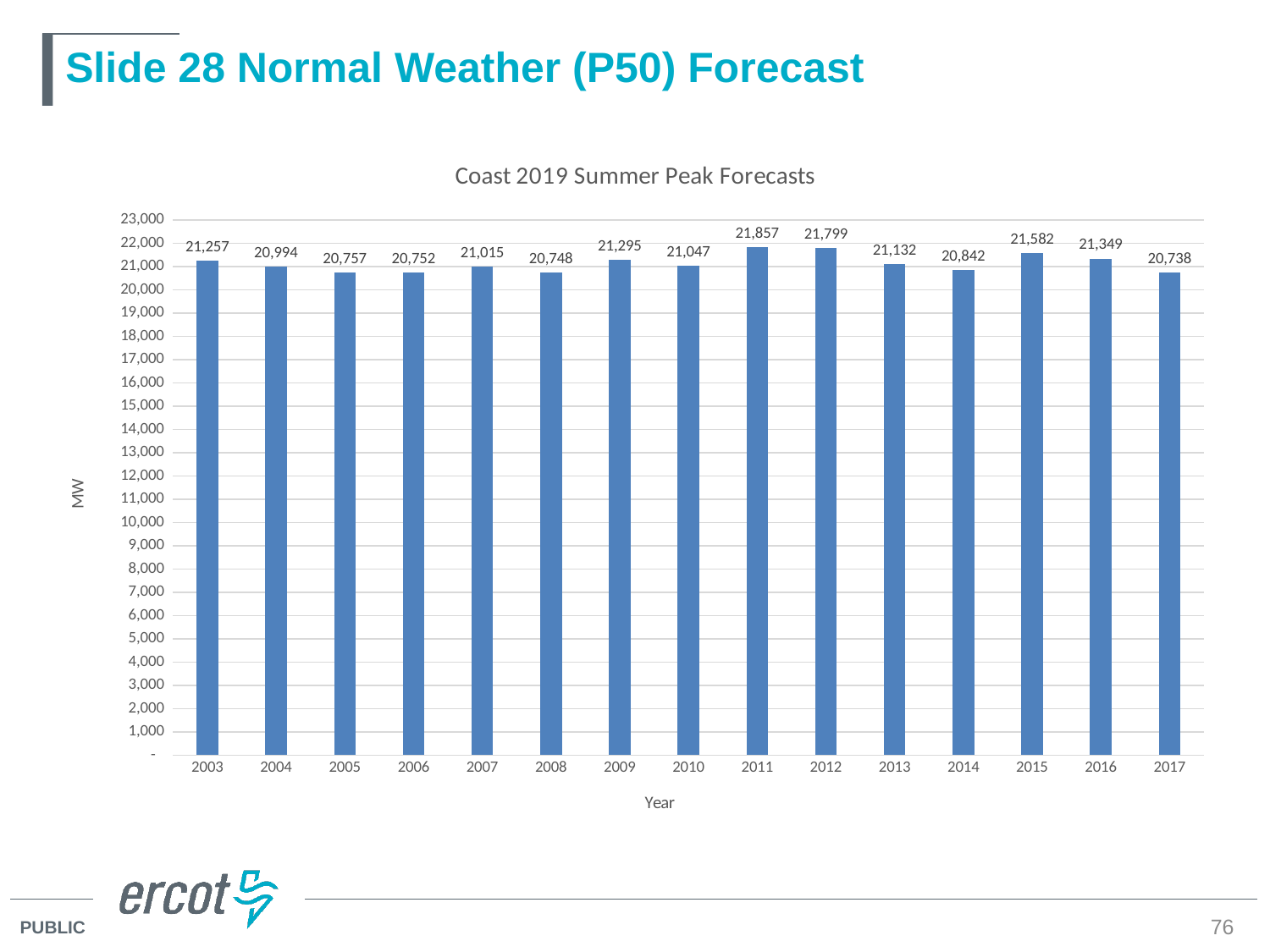
Which is larger, the value for 2015 or the value for 2016? 2015 What is the difference between the 2011 and 2012 forecast values? 58 What is the title of the chart? Coast 2019 Summer Peak Forecasts What is the forecast value for 2017? 20,738 Is the value for 2014 greater or less than 21,000? less What is the difference between the 2003 and 2004 forecast values? 263 Which year has the highest forecast value? 2011 What is the forecast value for 2011? 21,857 What is the forecast value for 2005? 20,757 Which year has the lowest forecast value? 2017 What kind of chart is shown on the slide? bar chart How many years are shown on the x axis? 15